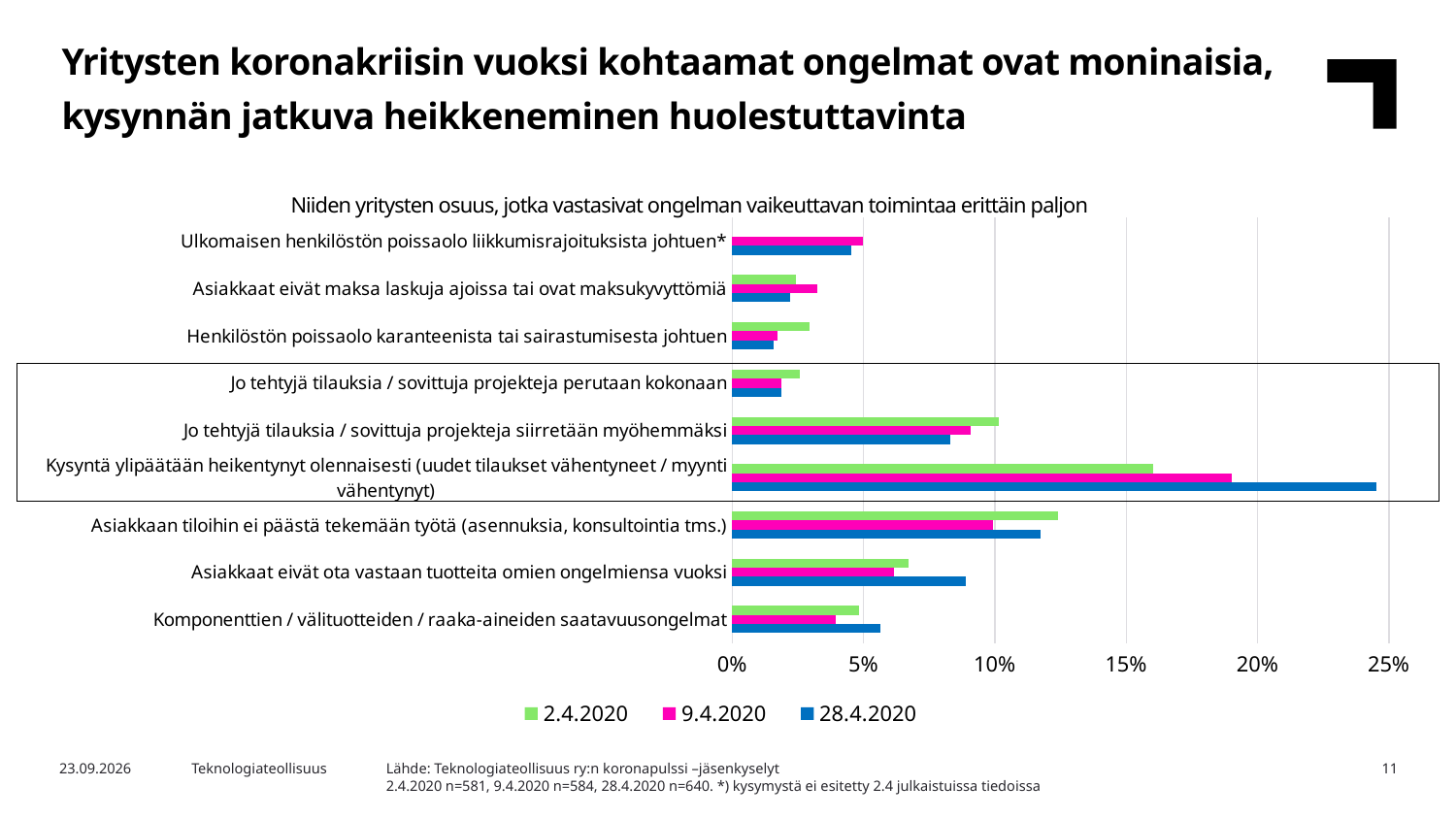
What kind of chart is shown on the slide? Bar chart Is the 28.4.2020 value for 'Kysyntä ylipäätään heikentynyt olennaisesti' greater or less than 20%? greater Which colour represents the 28.4.2020 series in the legend? Blue How many series does the legend list? 3 For 'Asiakkaat eivät ota vastaan tuotteita omien ongelmiensa vuoksi', which series has the larger value: 2.4.2020 or 28.4.2020? 28.4.2020 Is the 2.4.2020 value for 'Asiakkaan tiloihin ei päästä tekemään työtä' greater or less than 10%? greater Is the 2.4.2020 value for 'Jo tehtyjä tilauksia / sovittuja projekteja perutaan kokonaan' greater or less than 5%? less For 'Kysyntä ylipäätään heikentynyt olennaisesti', which series has the larger value: 2.4.2020 or 28.4.2020? 28.4.2020 Which category has the highest value for the 28.4.2020 series? Kysyntä ylipäätään heikentynyt olennaisesti (uudet tilaukset vähentyneet / myynti vähentynyt) How many categories (problem types) are plotted on the chart? 9